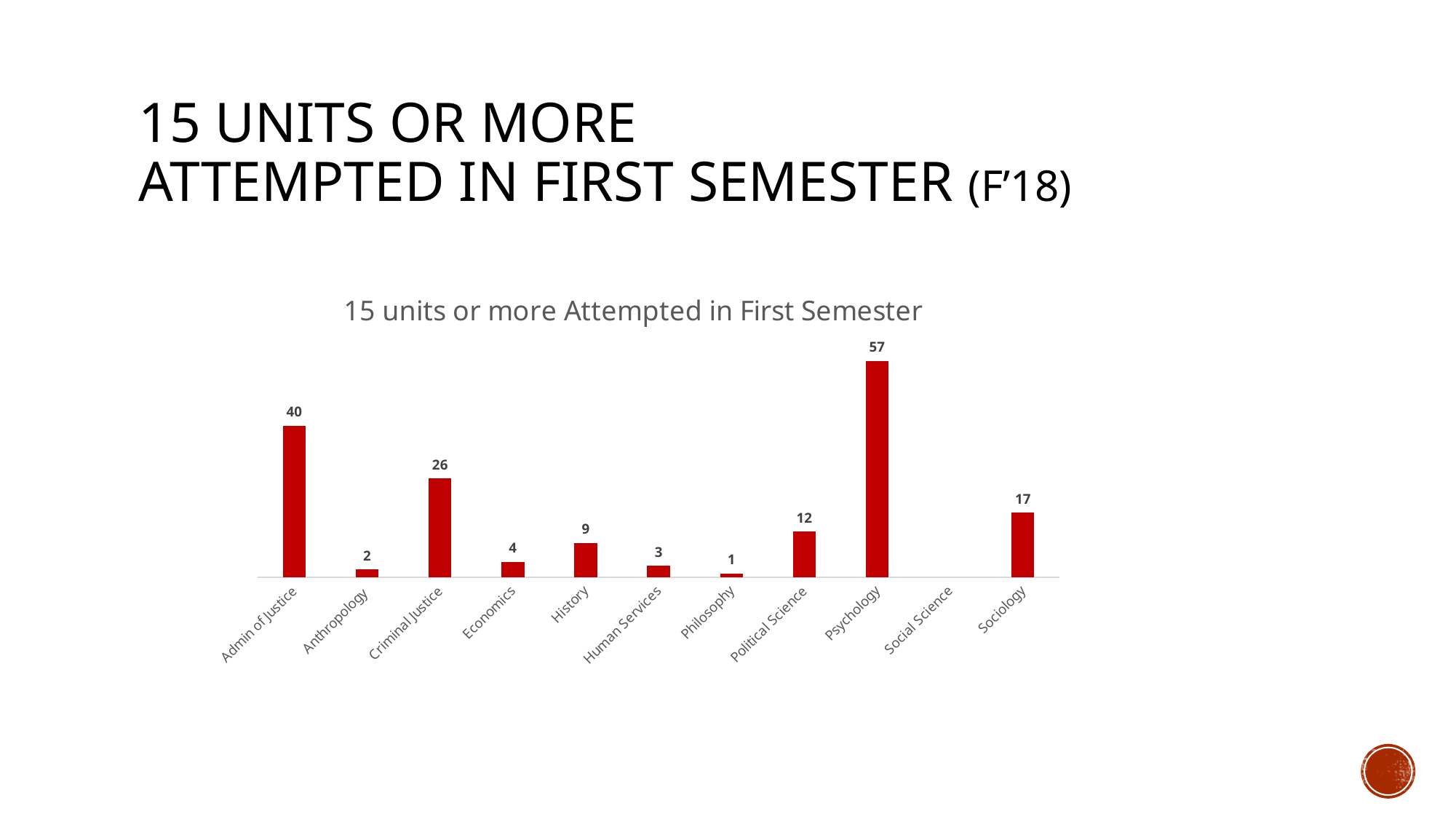
How many categories are shown on the x axis? 11 What is the title of the chart? 15 units or more Attempted in First Semester What is the value for Admin of Justice? 40 What is the value for Psychology? 57 Which is larger, the value for History or the value for Economics? History Which labelled category has the lowest non-zero value? Philosophy What is the difference between the values for Psychology and Admin of Justice? 17 What is the value for Sociology? 17 What is the difference between the values for Criminal Justice and Political Science? 14 Which category has the highest value? Psychology What is the value for Criminal Justice? 26 What kind of chart is shown on the slide? Bar chart